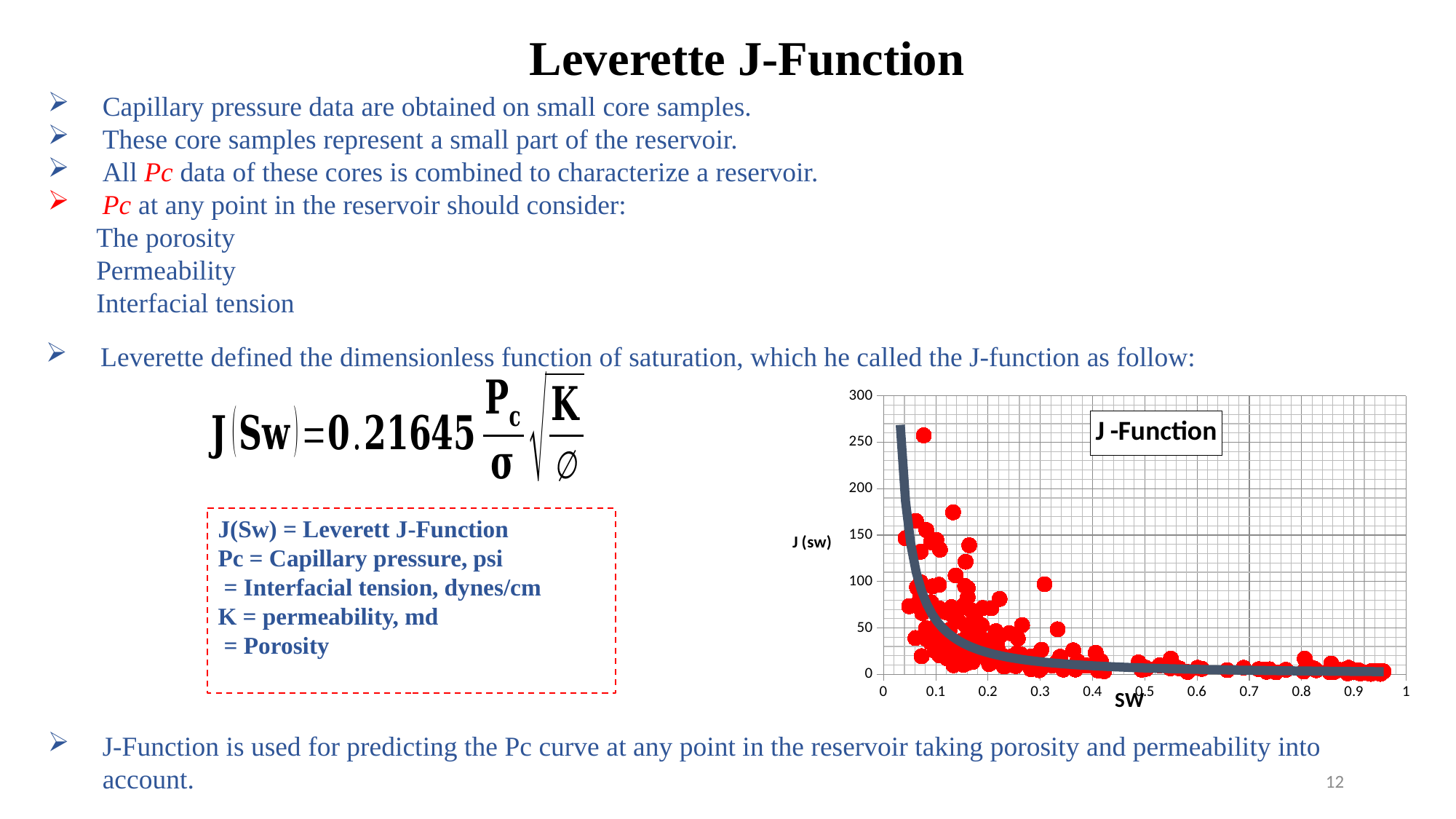
In the J -Function chart, are the J (sw) values at SW = 0.9 greater or less than 50? less In the J -Function chart, are the J (sw) values at SW = 0.5 greater or less than 100? less What is the title shown on the chart? J -Function What kind of chart is the J -Function chart? scatter chart What are the x-axis and y-axis labels of the J -Function chart? SW and J (sw) In the J -Function chart, is the highest plotted J (sw) value greater or less than 250? greater In the J -Function chart, is the J (sw) value at SW = 0.05 larger or smaller than the value at SW = 0.8? larger In the J -Function chart, are the highest J (sw) values found at SW below 0.2 or at SW above 0.5? below 0.2 In the J -Function chart, do the J (sw) values rise or fall as SW increases? fall